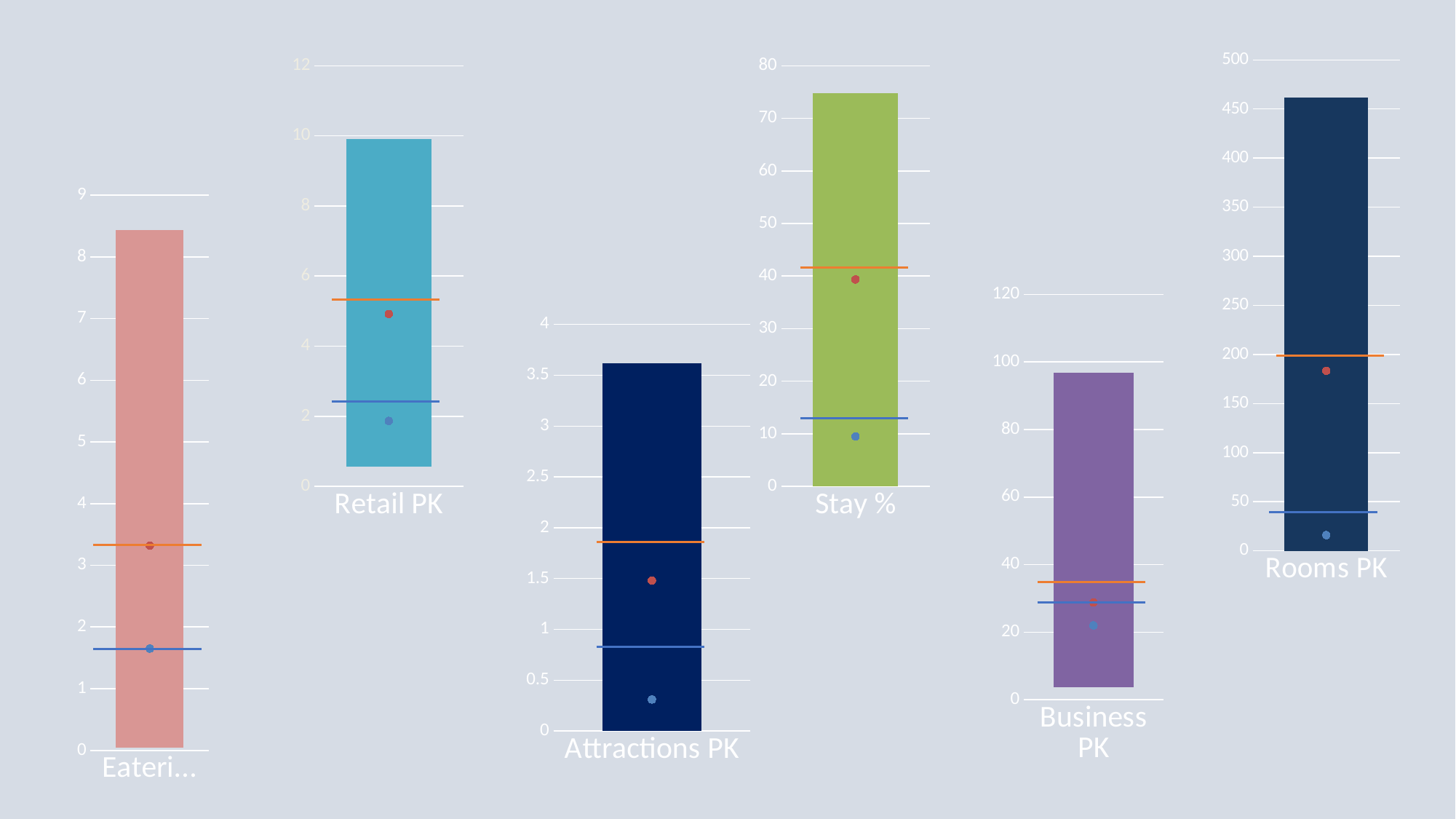
What is the highest axis tick value shown on the Business PK chart? 120 In the Rooms PK chart, is the red dot marker greater or less than 150? greater In the Stay % chart, is the top of the bar greater or less than 70? greater In the Stay % chart, is the blue dot marker greater or less than 20? less What is the highest axis tick value shown on the Rooms PK chart? 500 How many separate charts are shown on the slide? 6 What kind of chart is the Retail PK chart? bar chart